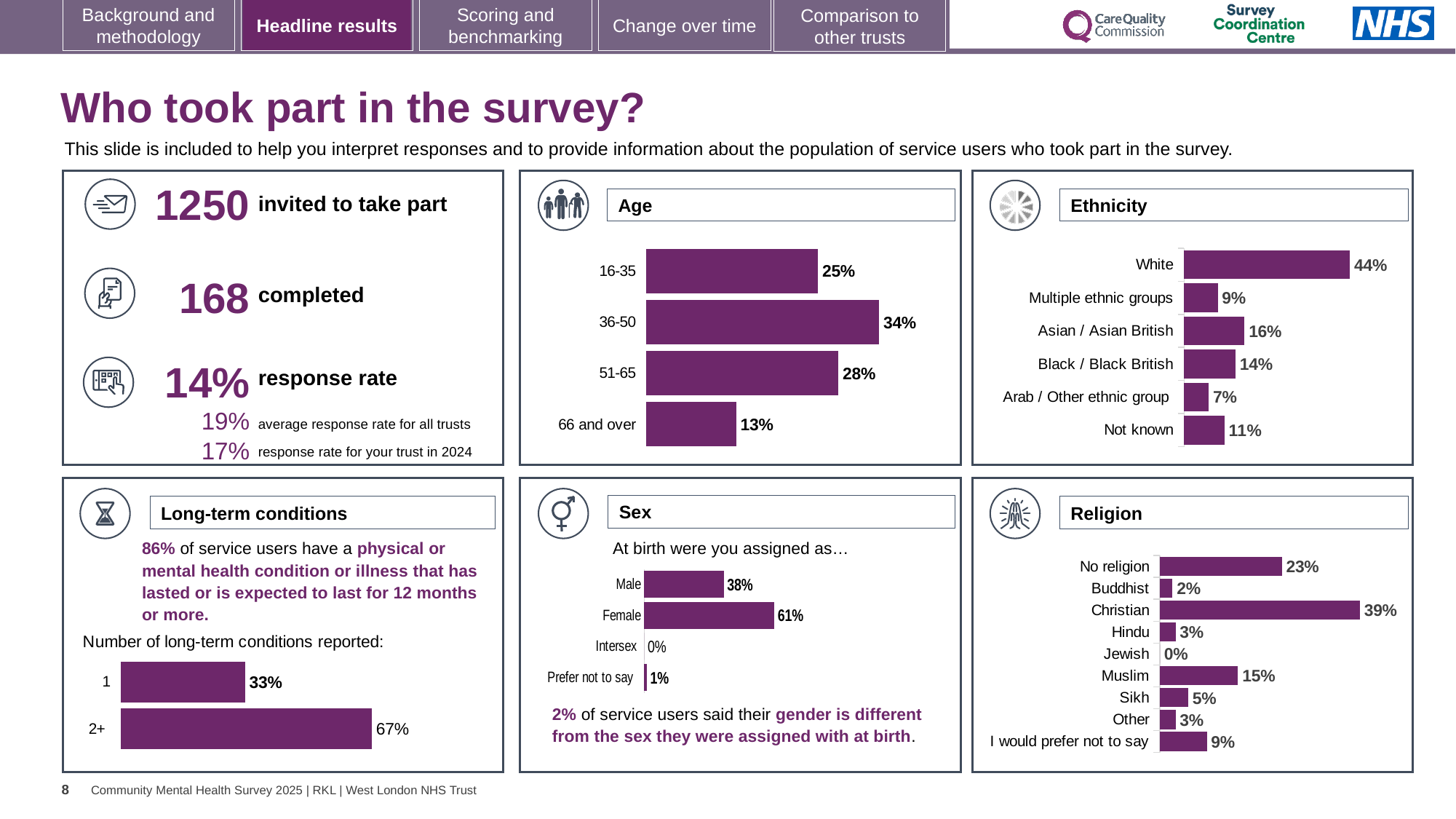
In the Age chart, what percentage of respondents were aged 36-50? 34% In the Long-term conditions chart, what percentage reported 2+ conditions? 67% In the Ethnicity chart, which category has the highest percentage? White In the Religion chart, how many categories are shown? 9 In the Ethnicity chart, what is the value for Asian / Asian British? 16% In the Ethnicity chart, what is the difference between White and Not known? 33% In the Sex chart, what is the value for Prefer not to say? 1% In the Religion chart, which religion has the highest percentage? Christian In the Age chart, which age group has the lowest percentage? 66 and over In the Sex chart, which is larger, Male or Female? Female What type of chart is used in the Age panel? Bar chart In the Religion chart, what is the value for Muslim? 15%